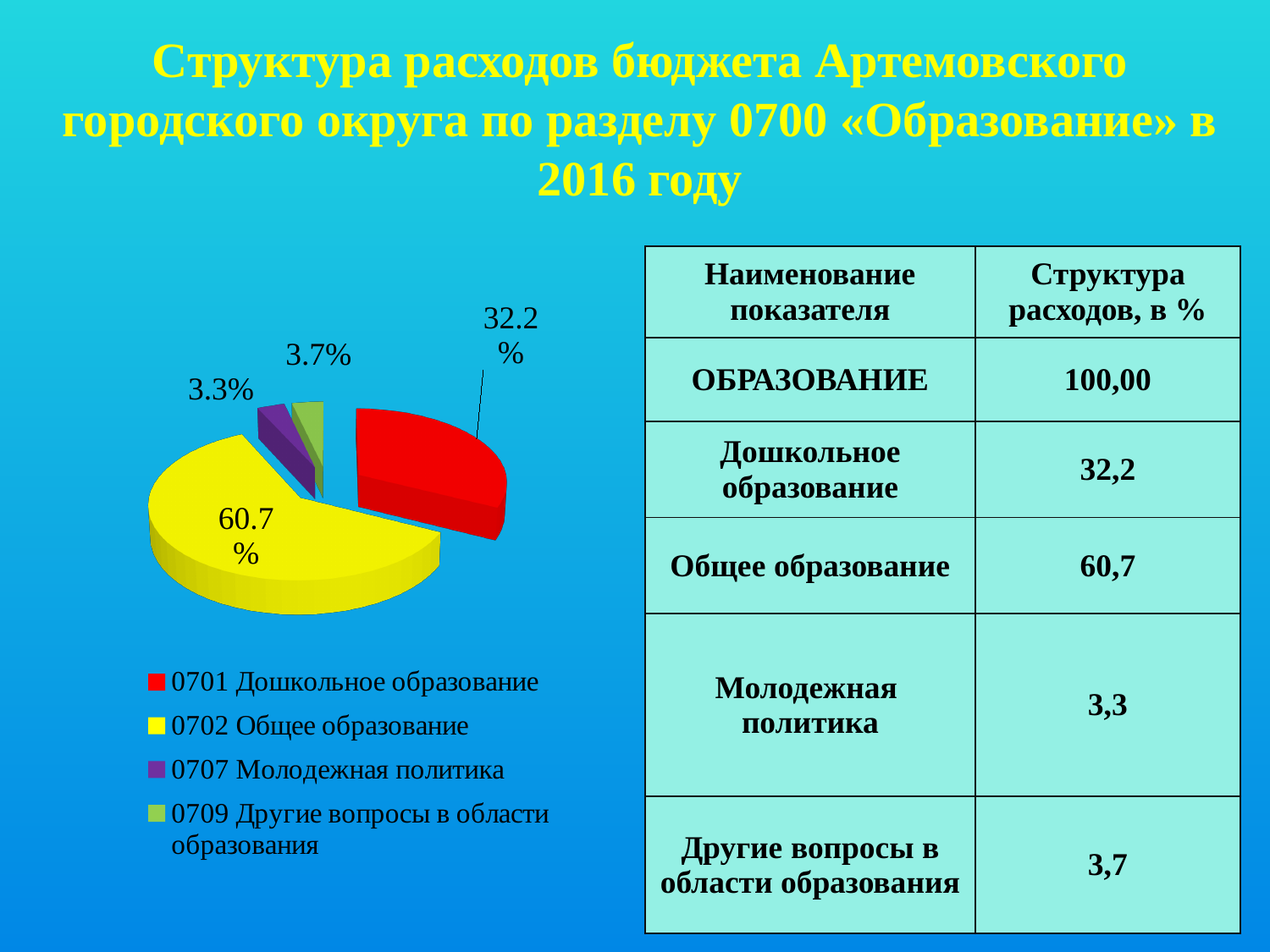
What share of the pie does 0709 Другие вопросы в области образования take? 3.7% Which category has the smallest slice of the pie? 0707 Молодежная политика How many slices does the pie chart have? 4 What is the difference in percentage points between 0702 Общее образование and 0701 Дошкольное образование? 28.5 What share of the pie does 0707 Молодежная политика take? 3.3% What share of the pie does 0701 Дошкольное образование take? 32.2% What share of the pie does 0702 Общее образование take? 60.7% Which category has the largest slice of the pie? 0702 Общее образование How many entries does the legend of the pie chart list? 4 What colour is the slice for 0701 Дошкольное образование? red What kind of chart is shown on the slide? pie chart Which is larger: the slice for 0709 Другие вопросы в области образования or the slice for 0707 Молодежная политика? 0709 Другие вопросы в области образования